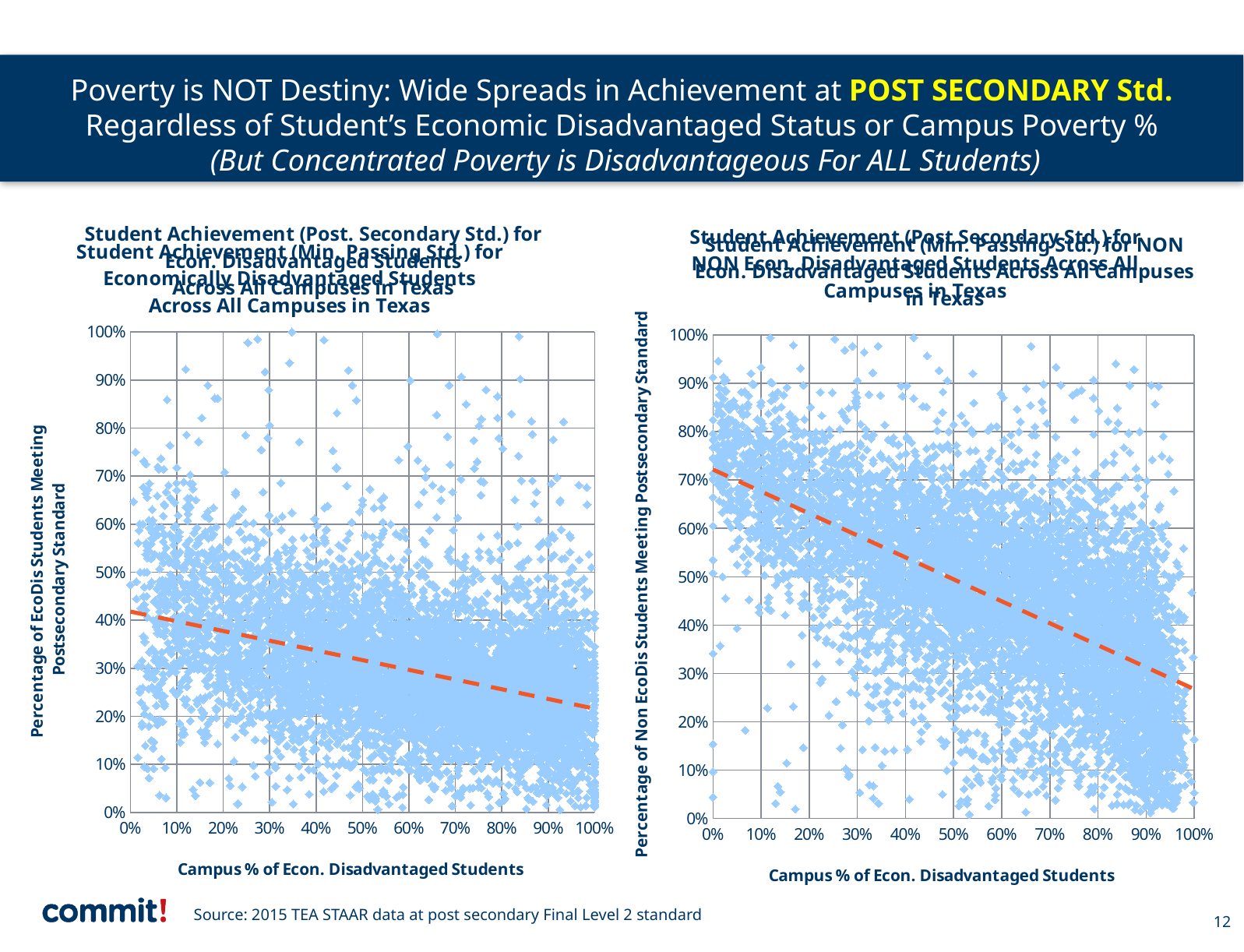
What is the x-axis label of the left chart (Econ. Disadvantaged Students)? Campus % of Econ. Disadvantaged Students In the right chart (NON Econ. Disadvantaged Students), is the value of the dashed trend line at 100% on the x axis greater or less than 40%? less In the left chart (Econ. Disadvantaged Students), does the dashed trend line rise or fall as Campus % of Econ. Disadvantaged Students increases? fall What is the y-axis label of the right chart (NON Econ. Disadvantaged Students)? Percentage of Non EcoDis Students Meeting Postsecondary Standard In the left chart (Econ. Disadvantaged Students), is the value of the dashed trend line at 0% on the x axis greater or less than 30%? greater Comparing the dashed trend lines at 0% on the x axis, which chart's trend line starts higher: the left chart (Econ. Disadvantaged) or the right chart (NON Econ. Disadvantaged)? the right chart (NON Econ. Disadvantaged) What kind of chart is the right chart, titled 'Student Achievement ... for NON Econ. Disadvantaged Students Across All Campuses in Texas'? scatter chart In the right chart (NON Econ. Disadvantaged Students), does the dashed trend line rise or fall as Campus % of Econ. Disadvantaged Students increases? fall In the left chart (Econ. Disadvantaged Students), what is the highest value shown on the y axis? 100% In the right chart (NON Econ. Disadvantaged Students), is the value of the dashed trend line at 0% on the x axis greater or less than 60%? greater What kind of chart is the left chart, titled 'Student Achievement ... for Econ. Disadvantaged Students Across All Campuses in Texas'? scatter chart